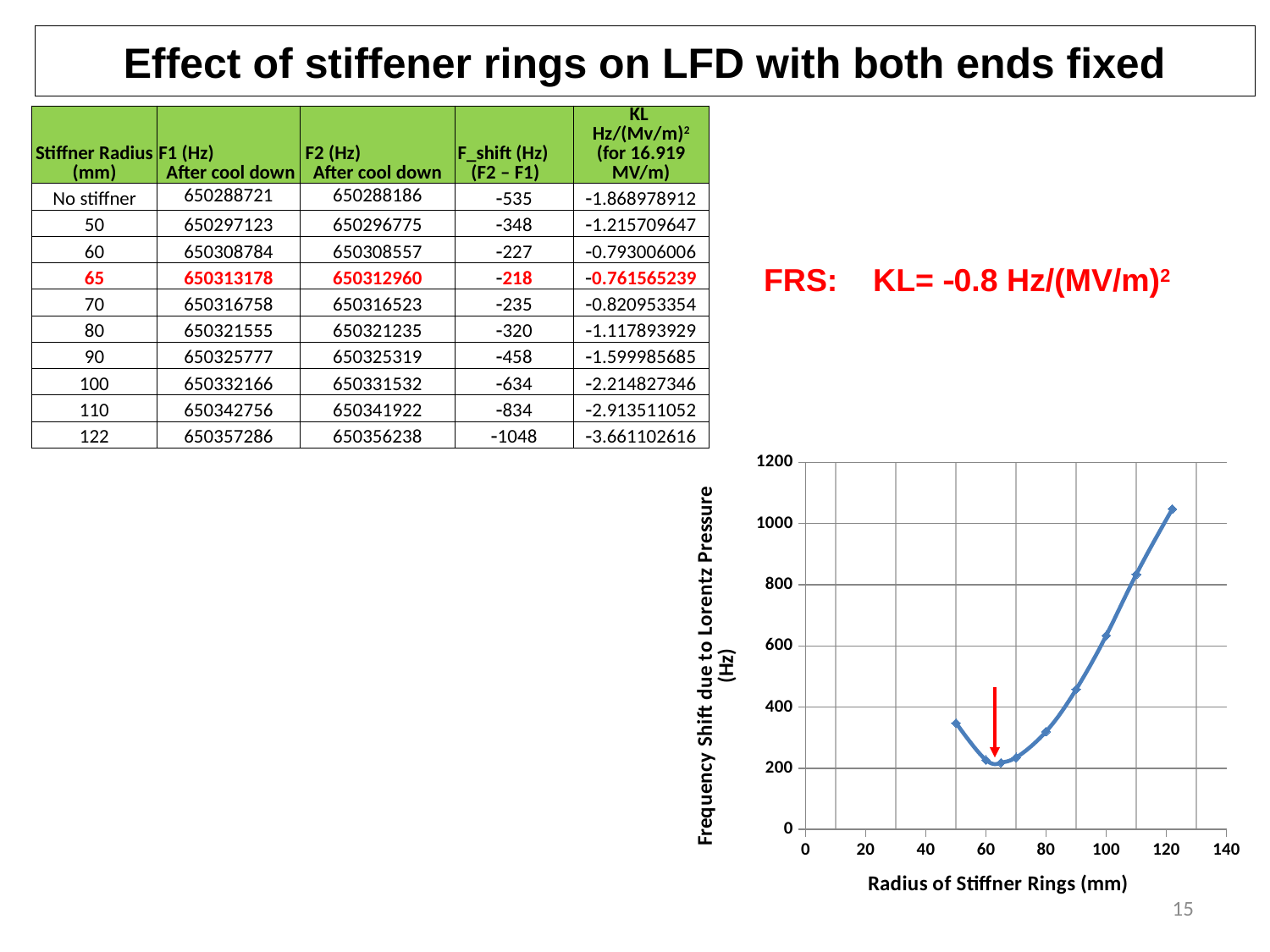
Is the frequency shift plotted at a radius of 122 mm greater or less than 1000? greater Is the frequency shift plotted at a radius of 110 mm greater or less than 800? greater At which radius of stiffener rings is the plotted frequency shift lowest? 65 mm Does the plotted frequency shift rise or fall as the radius increases from 65 mm to 122 mm? rise What is the title of the x axis of the chart? Radius of Stiffner Rings (mm) What is the title of the y axis of the chart? Frequency Shift due to Lorentz Pressure (Hz) What kind of chart is shown on the slide? line chart Which has the larger plotted frequency shift: a radius of 100 mm or a radius of 70 mm? 100 mm Is the frequency shift plotted at a radius of 80 mm greater or less than 400? less At which radius of stiffener rings is the plotted frequency shift highest? 122 mm How many data points are plotted on the chart? 9